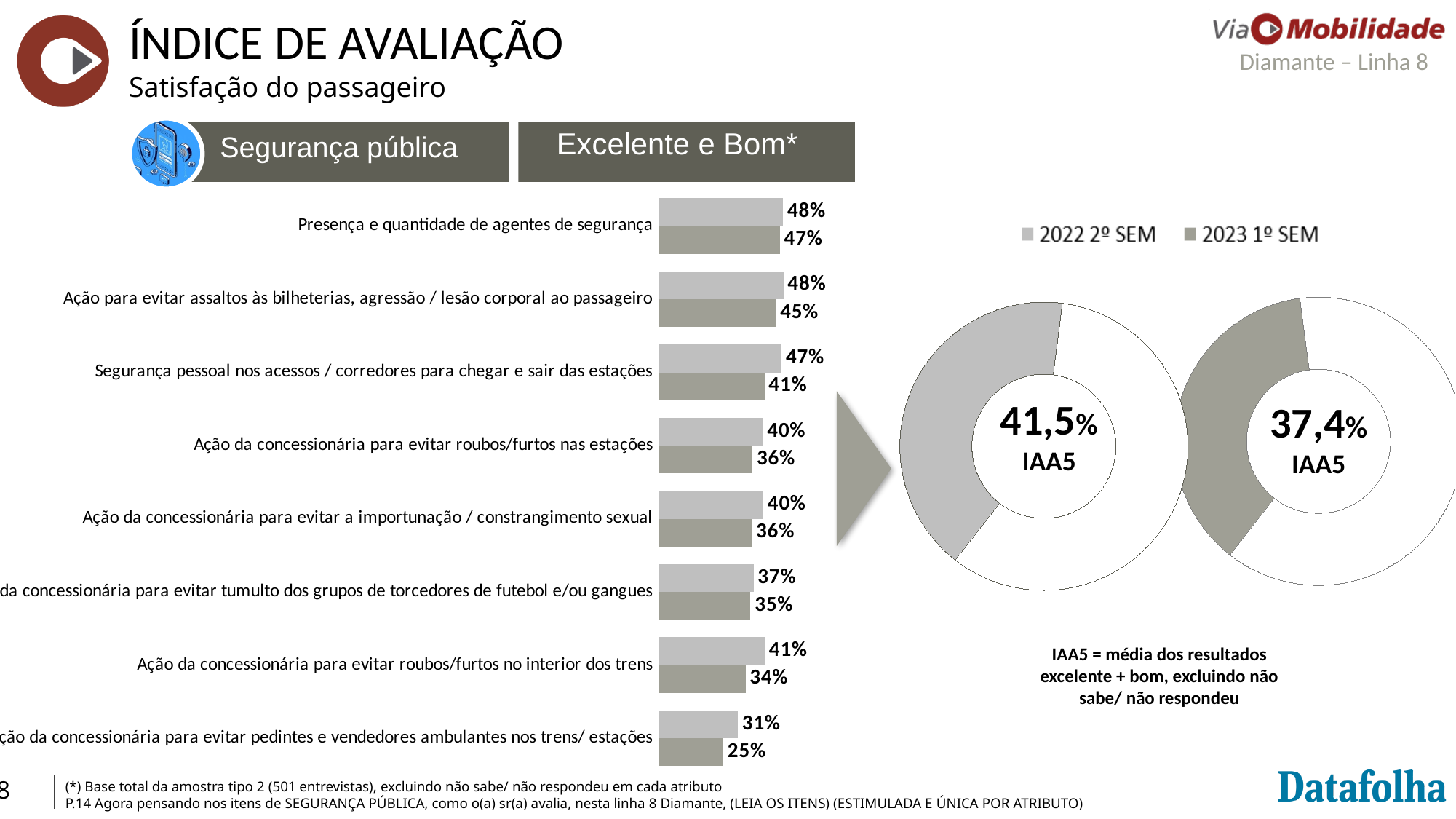
How many categories are shown in the bar chart? 8 What IAA5 value is shown in the left donut chart (2022 2º SEM)? 41,5% In the bar chart, which category has the lowest 2023 1º SEM value? Ação da concessionária para evitar pedintes e vendedores ambulantes nos trens/ estações In the bar chart, which is larger for 'Ação para evitar assaltos às bilheterias, agressão / lesão corporal ao passageiro': the 2022 2º SEM value or the 2023 1º SEM value? 2022 2º SEM In the bar chart, what is the 2023 1º SEM value for 'Presença e quantidade de agentes de segurança'? 47% In the bar chart, what is the 2023 1º SEM value for 'Ação da concessionária para evitar roubos/furtos no interior dos trens'? 34% In the bar chart, what is the difference between the 2022 2º SEM and 2023 1º SEM values for 'Ação da concessionária para evitar roubos/furtos no interior dos trens'? 7 percentage points What IAA5 value is shown in the right donut chart (2023 1º SEM)? 37,4% What type of chart is used to show the 'Excelente e Bom' results by category? Bar chart In the bar chart, which category has the highest 2023 1º SEM value? Presença e quantidade de agentes de segurança How many series does the legend list? 2 In the bar chart, what is the 2022 2º SEM value for 'Segurança pessoal nos acessos / corredores para chegar e sair das estações'? 47%